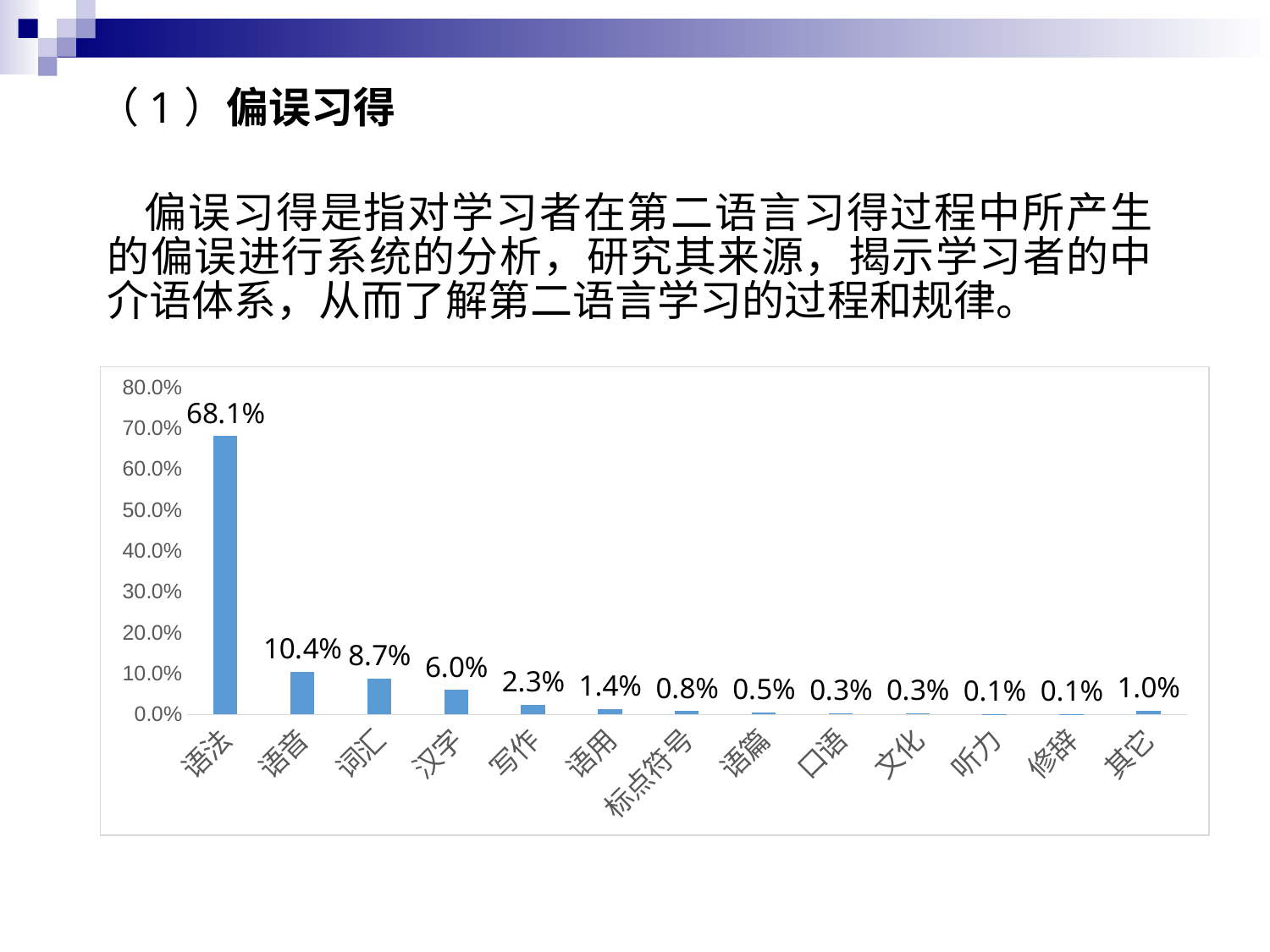
What is the value for 语法? 68.1% What is the value for 语音? 10.4% Which category has the highest value? 语法 What is the difference between the values for 语音 and 词汇? 1.7% What is the value for 其它? 1.0% What kind of chart is shown on the slide? bar chart Is the value for 语法 greater or less than 60.0%? greater What is the difference between the values for 语法 and 语音? 57.7% What is the value for 标点符号? 0.8% Which is larger, the value for 写作 or the value for 语用? 写作 How many categories are shown on the x axis? 13 What is the value for 汉字? 6.0%